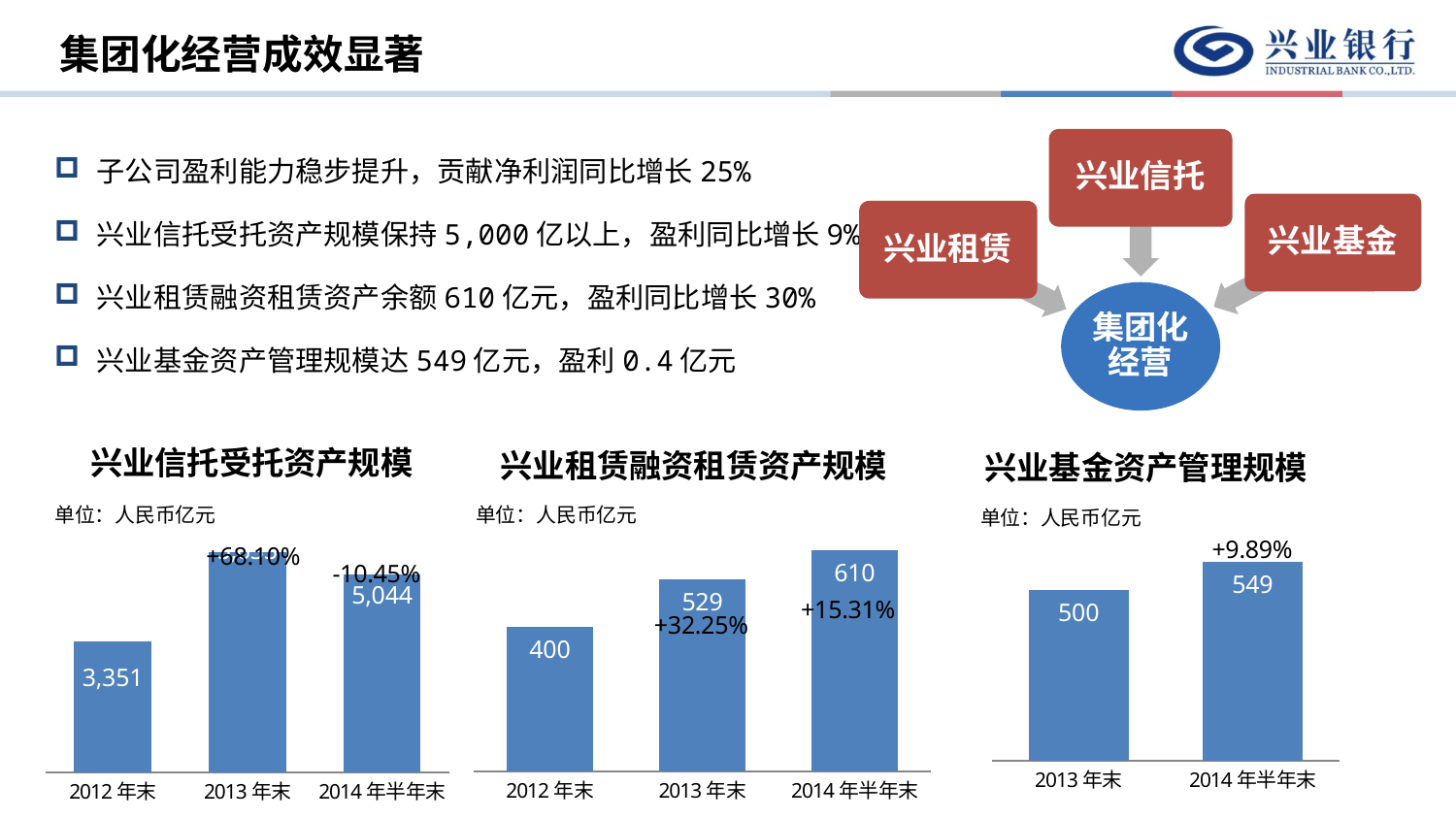
In the 兴业租赁融资租赁资产规模 chart, what is the value for 2013 年末? 529 In the 兴业基金资产管理规模 chart, what is the value for 2014 年半年末? 549 In the 兴业信托受托资产规模 chart, what is the value for 2014 年半年末? 5,044 In the 兴业租赁融资租赁资产规模 chart, which period has the lowest value? 2012 年末 In the 兴业信托受托资产规模 chart, which period has the highest bar? 2013 年末 In the 兴业租赁融资租赁资产规模 chart, do the values rise or fall from 2012 年末 to 2014 年半年末? rise What type of chart is the 兴业基金资产管理规模 chart? bar chart In the 兴业基金资产管理规模 chart, how many bars are plotted? 2 In the 兴业信托受托资产规模 chart, what is the value for 2012 年末? 3,351 In the 兴业租赁融资租赁资产规模 chart, what is the difference between the 2014 年半年末 and 2012 年末 values? 210 In the 兴业基金资产管理规模 chart, what growth rate is shown for 2014 年半年末? +9.89% In the 兴业信托受托资产规模 chart, what growth rate is shown above the 2014 年半年末 bar? -10.45%